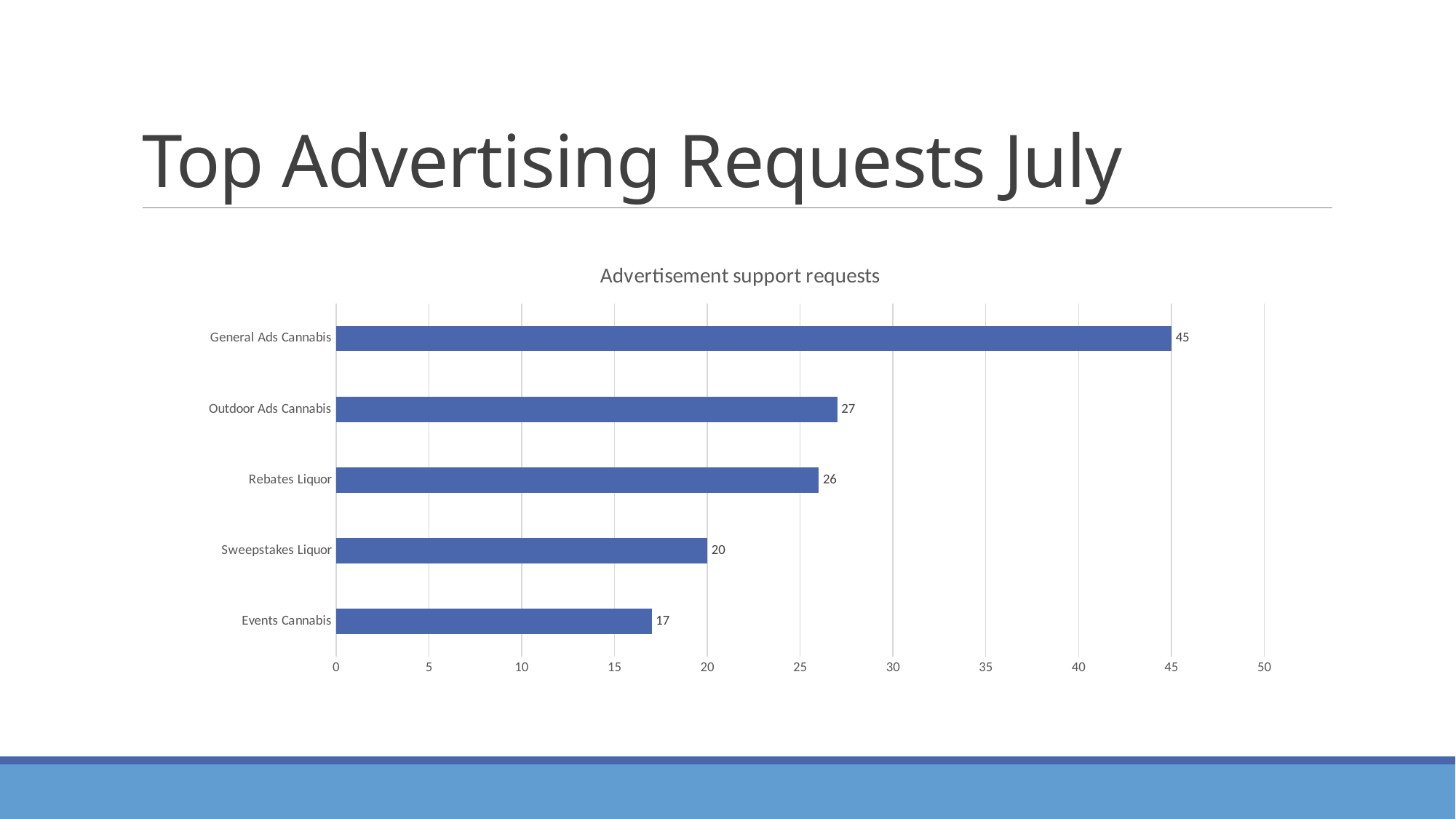
What is the title of the chart? Advertisement support requests What is the value for General Ads Cannabis? 45 What is the value for Outdoor Ads Cannabis? 27 What is the value for Events Cannabis? 17 What kind of chart is shown on the slide? Bar chart What is the difference between the values for General Ads Cannabis and Outdoor Ads Cannabis? 18 Which category has the lowest value? Events Cannabis Which category has the highest value? General Ads Cannabis What is the value for Rebates Liquor? 26 Which is larger, the value for Sweepstakes Liquor or the value for Events Cannabis? Sweepstakes Liquor How many categories are shown in the chart? 5 What is the value for Sweepstakes Liquor? 20